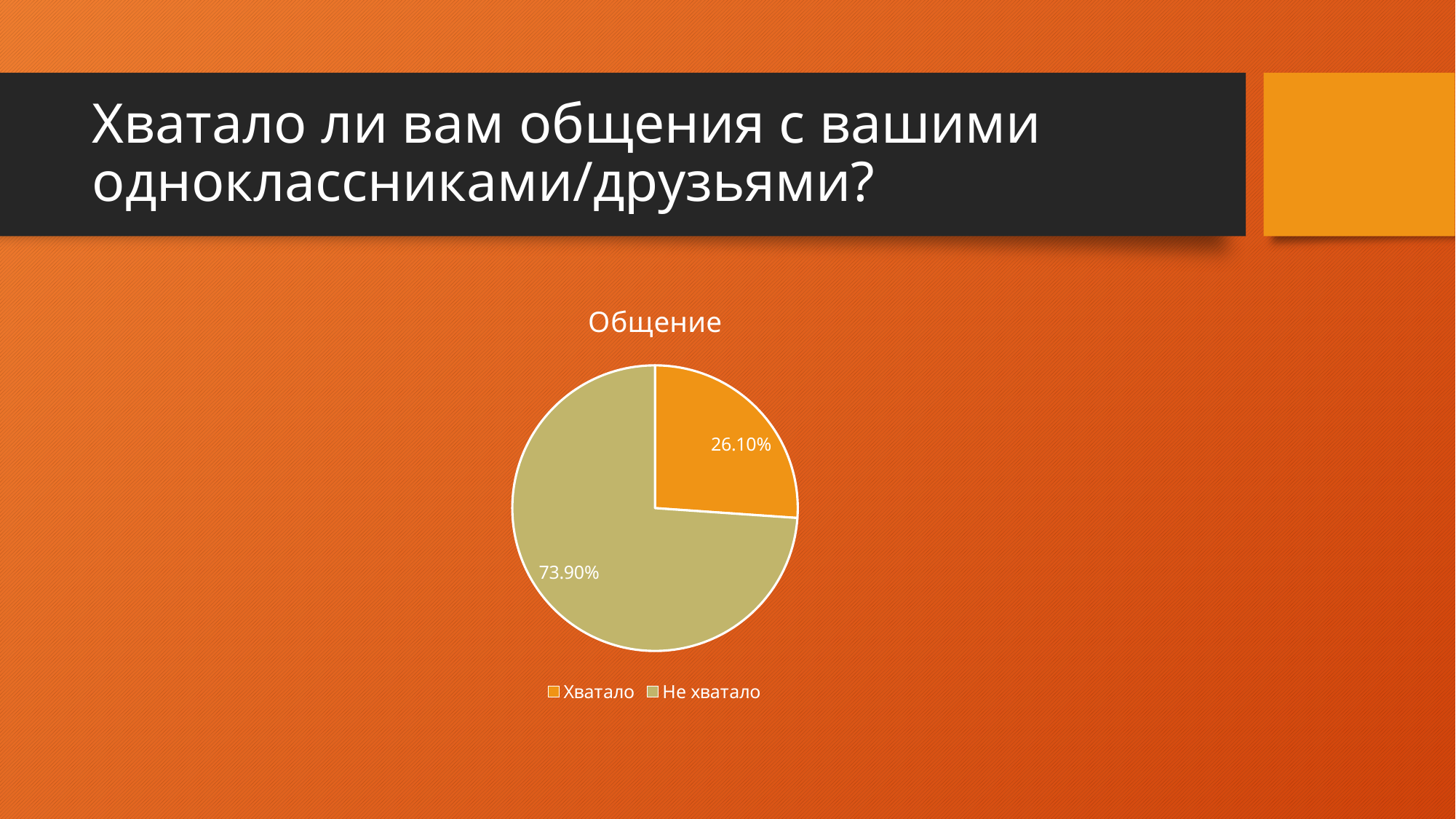
Which category has the largest slice of the pie? Не хватало How many entries does the legend list? 2 Which is larger: the share for "Хватало" or the share for "Не хватало"? Не хватало Which colour represents "Хватало" in the pie chart? orange What share of the pie does "Хватало" take? 26.10% What is the difference between the shares of "Не хватало" and "Хватало"? 47.80% How many categories does the pie chart have? 2 Which category has the smallest slice of the pie? Хватало What is the title of the chart? Общение What share of the pie does "Не хватало" take? 73.90% What kind of chart is shown on the slide? pie chart